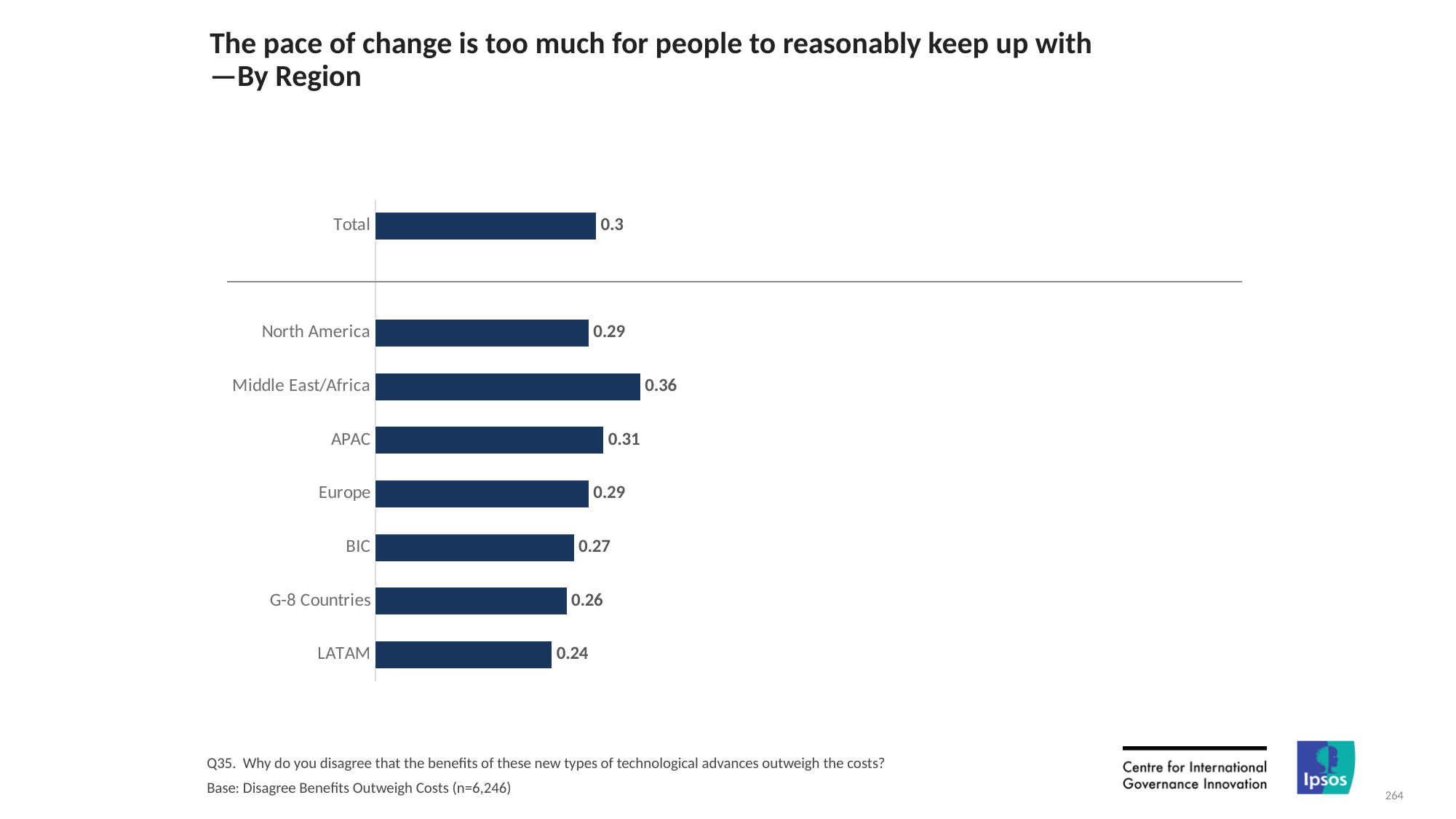
What is the difference between the values for APAC and BIC? 0.04 What is the value for Total? 0.3 What is the difference between the values for Middle East/Africa and LATAM? 0.12 What is the value for G-8 Countries? 0.26 Which region has the highest value? Middle East/Africa What is the title of the chart? The pace of change is too much for people to reasonably keep up with—By Region Which is larger, the value for APAC or the value for Europe? APAC Which region has the lowest value? LATAM What is the value for LATAM? 0.24 What kind of chart is shown on the slide? Bar chart What is the value for Middle East/Africa? 0.36 How many bars are shown in the chart, including Total? 8